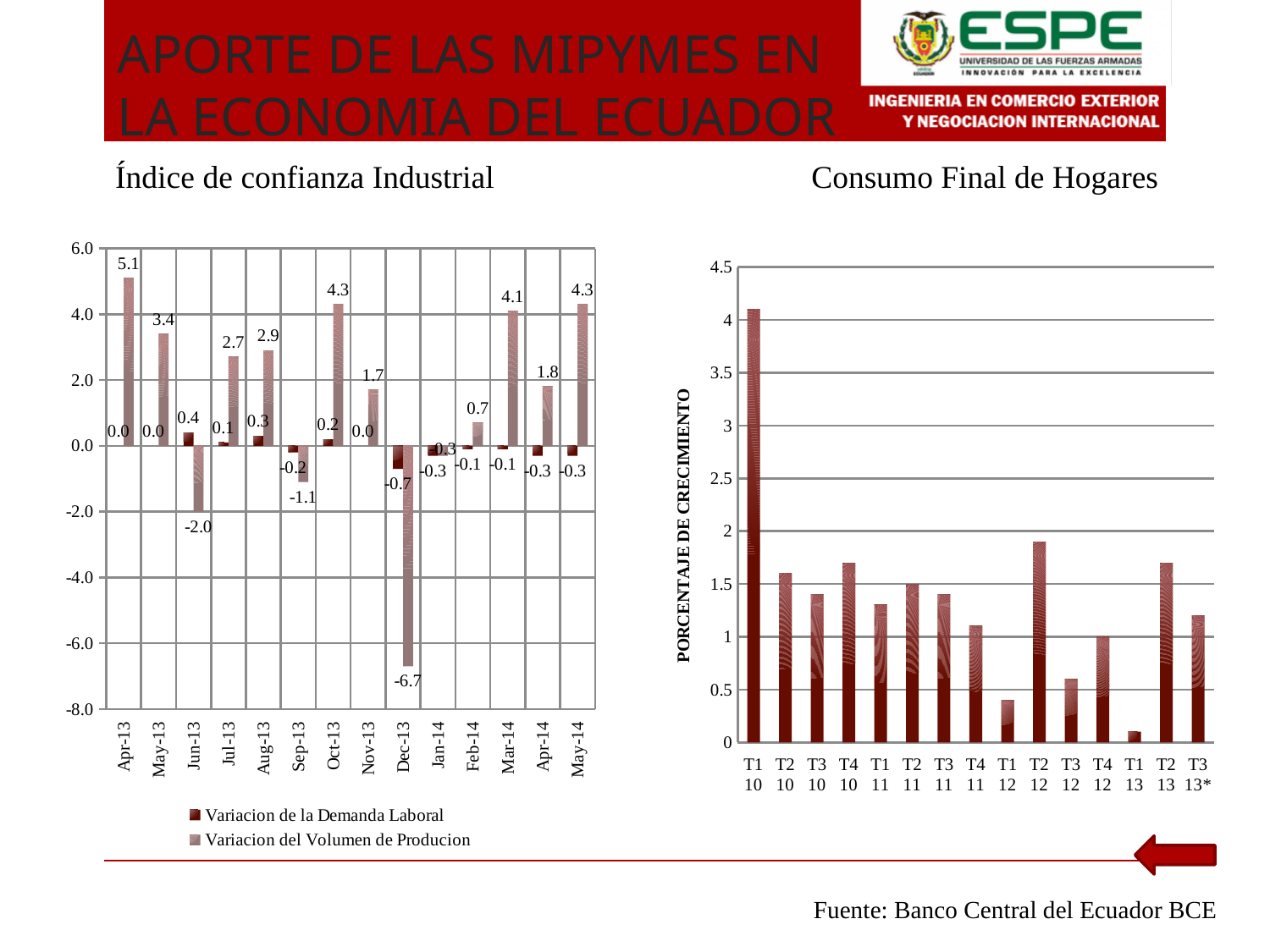
In the 'Índice de confianza Industrial' chart, what is the difference between Variacion del Volumen de Producion and Variacion de la Demanda Laboral for Oct-13? 4.1 In the 'Consumo Final de Hogares' chart, which quarter has the highest value? T1 10 In the 'Consumo Final de Hogares' chart, is the value for T2 12 greater or less than 1.5? greater In the 'Índice de confianza Industrial' chart, which month has the highest Variacion del Volumen de Producion? Apr-13 In the 'Índice de confianza Industrial' chart, which is larger: Variacion del Volumen de Producion for Mar-14 or for Apr-14? Mar-14 In the 'Índice de confianza Industrial' chart, which month has the lowest Variacion del Volumen de Producion? Dec-13 What kind of chart is the 'Consumo Final de Hogares' chart? bar chart How many months are shown on the x axis of the 'Índice de confianza Industrial' chart? 14 In the 'Índice de confianza Industrial' chart, what is the value of Variacion del Volumen de Producion for Dec-13? -6.7 In the 'Consumo Final de Hogares' chart, which quarter has the lowest value? T1 13 In the 'Índice de confianza Industrial' chart, what is the value of Variacion de la Demanda Laboral for Jun-13? 0.4 How many series does the legend of the 'Índice de confianza Industrial' chart list? 2